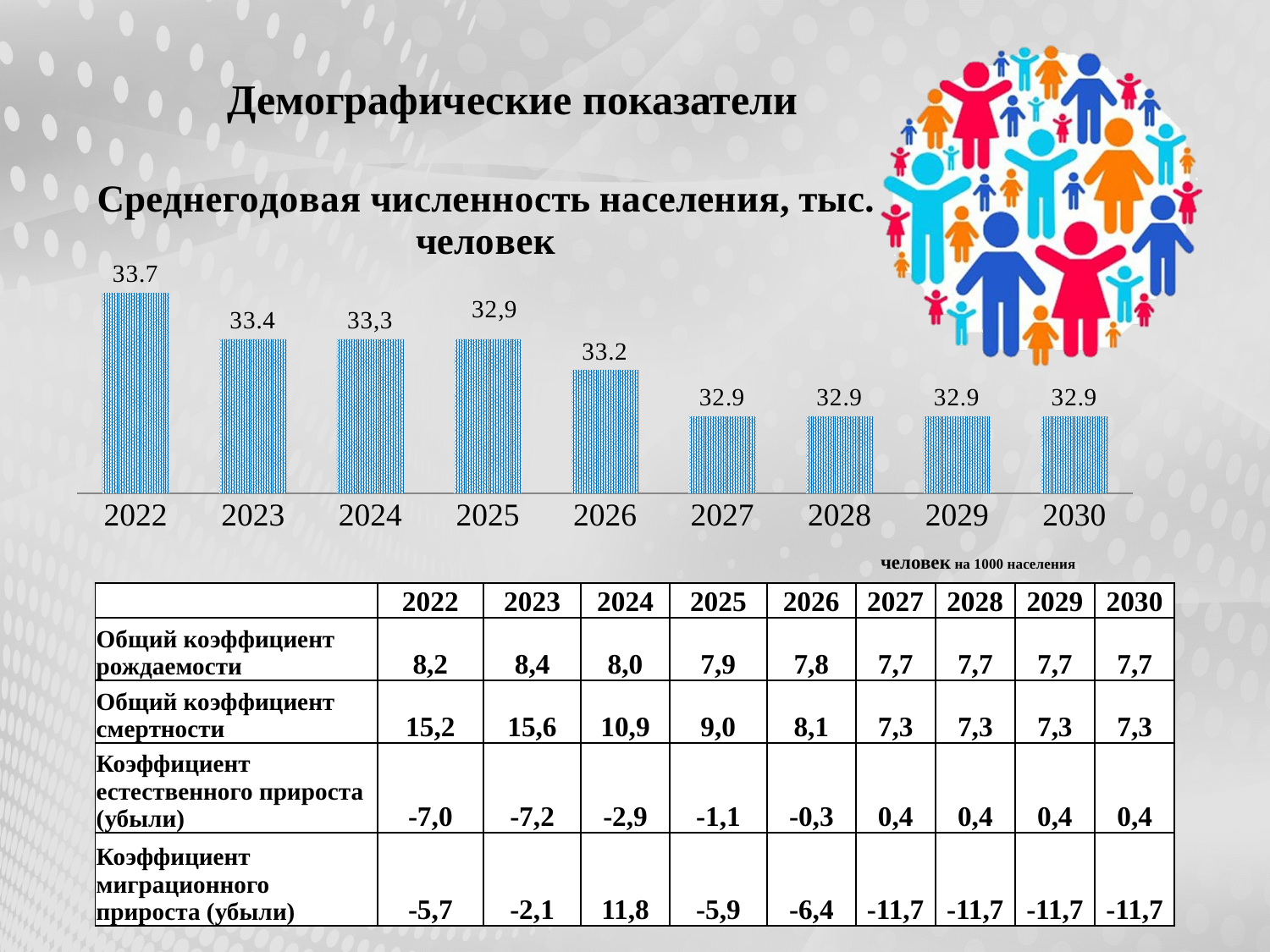
What is the value for 2030 in the chart? 32.9 Which year has the highest value in the chart? 2022 What is the value for 2023 in the chart? 33.4 What kind of chart is shown on the slide? bar chart What is the difference between the values for 2022 and 2023? 0.3 How many years are shown on the x axis of the chart? 9 Which is larger, the value for 2022 or the value for 2027? 2022 Do the values in the chart generally rise or fall from 2022 to 2030? fall What is the difference between the values for 2022 and 2030? 0.8 What is the value for 2026 in the chart? 33.2 What is the value for 2022 in the chart? 33.7 What is the value for 2024 in the chart? 33,3